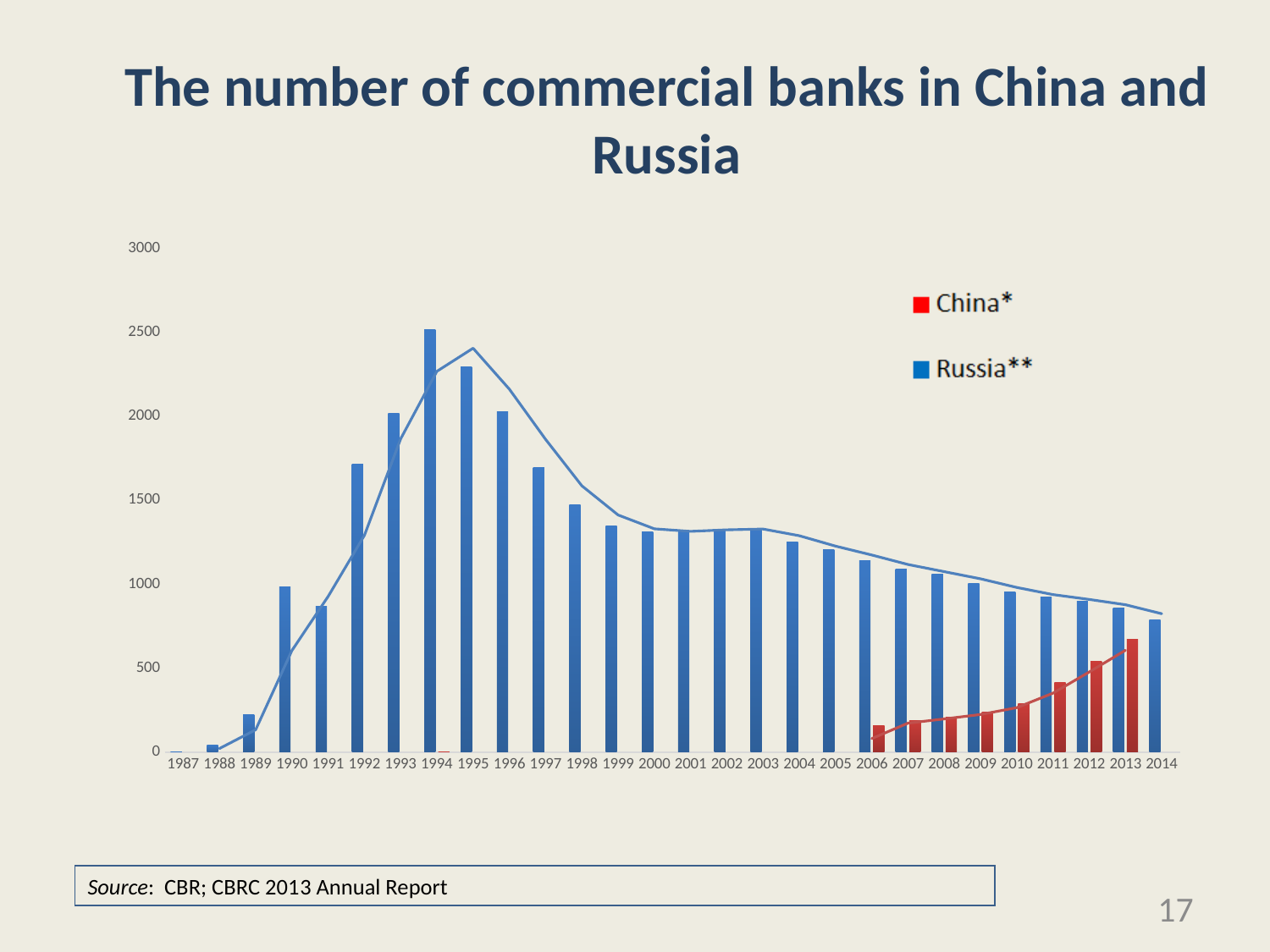
Which is larger, the Russia** bar for 1994 or for 1995? 1994 How many series does the legend list? 2 How many years are shown along the x axis? 28 Is the China* value for 2006 greater or less than 500? less In which year is the Russia** bar highest? 1994 What kind of chart is shown on the slide? bar chart Is the Russia** value for 2014 greater or less than 1000? less Is the China* value for 2013 greater or less than 500? greater Do the Russia** values rise or fall from 1995 to 2014? fall In which year is the China* bar highest? 2013 What colour represents China* in the legend? red